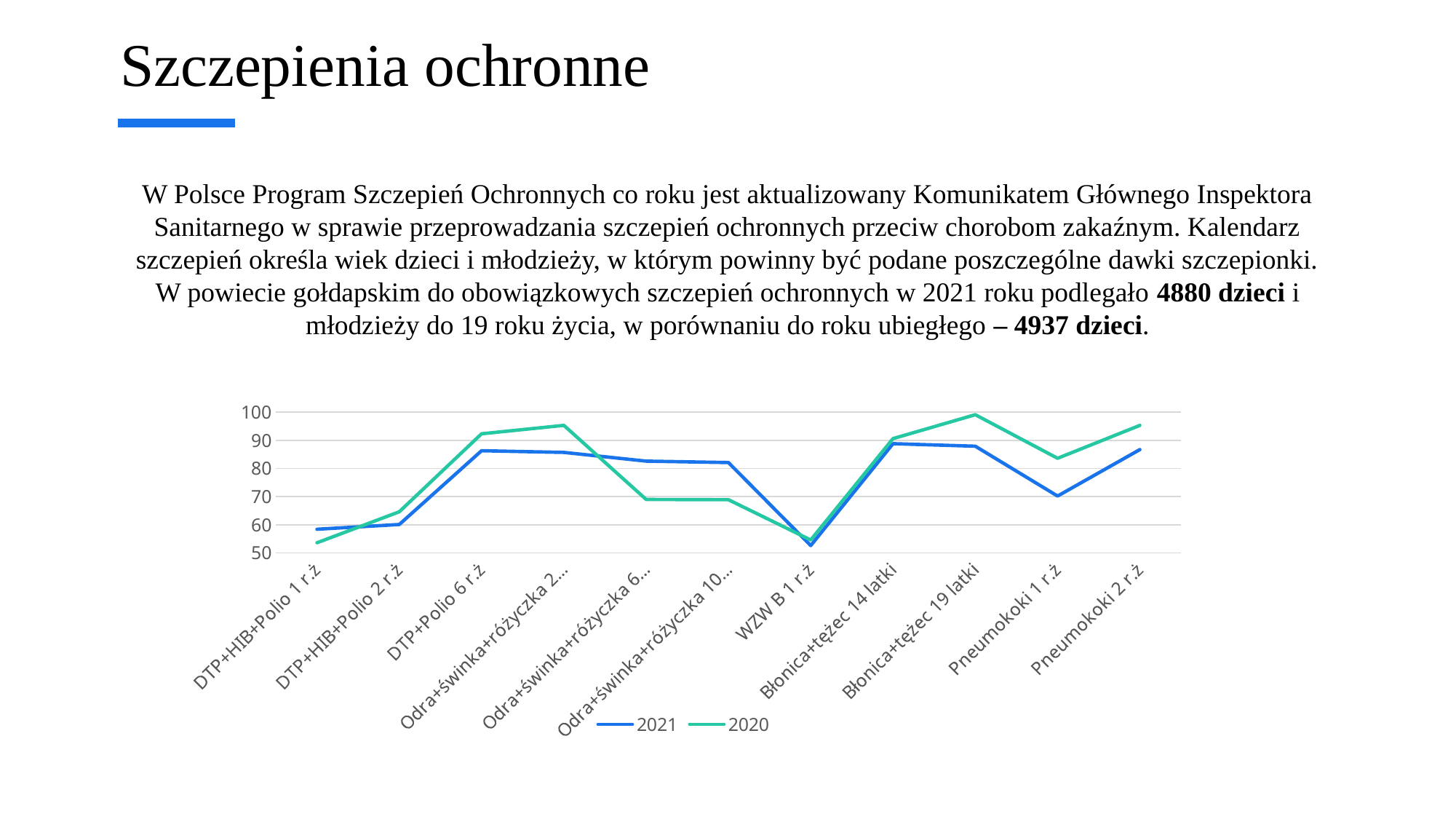
Is the 2021 value for WZW B 1 r.ż greater or less than 60? less For Pneumokoki 1 r.ż, which series has the larger value, 2021 or 2020? 2020 For the 2021 series, which category has the lowest value? WZW B 1 r.ż Is the 2020 value for Pneumokoki 2 r.ż greater or less than 90? greater Is the 2021 value for Pneumokoki 1 r.ż greater or less than 80? less Do the values for both series rise or fall from Błonica+tężec 19 latki to Pneumokoki 1 r.ż? fall What kind of chart is shown on the slide? line chart How many vaccination categories are shown on the x axis of the chart? 11 Which years are listed in the chart legend? 2021 and 2020 For Odra+świnka+różyczka 6..., which series has the larger value, 2021 or 2020? 2021 For the 2020 series, which category has the highest value? Błonica+tężec 19 latki How many series does the chart legend list? 2